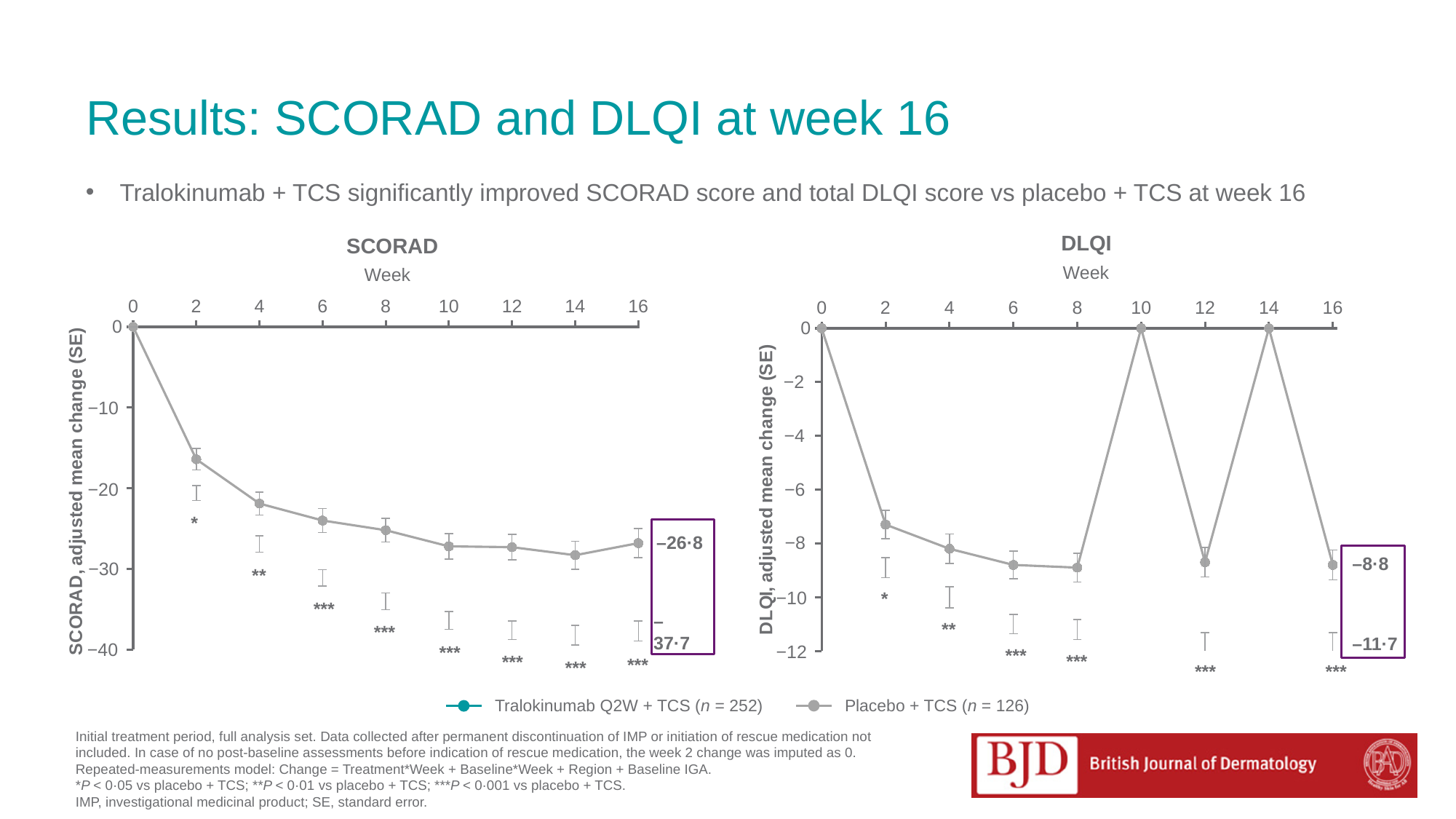
What type of chart is the SCORAD chart? line chart In the DLQI chart, is the Placebo + TCS value at week 2 greater or less than −6? less In the SCORAD chart, what is the adjusted mean change for Placebo + TCS at week 16? −26·8 In the DLQI chart, what is the difference between the two week 16 values shown, −11·7 and −8·8? 2·9 In the DLQI chart, what is the adjusted mean change for Placebo + TCS at week 16? −8·8 In the SCORAD chart, what is the difference between the two week 16 values shown, −37·7 and −26·8? 10·9 In the SCORAD chart, how many week time points are shown on the x axis? 9 In the SCORAD chart, is the Placebo + TCS value at week 2 greater or less than −10? less In the SCORAD chart, does the Placebo + TCS line rise or fall from week 0 to week 8? fall According to the legend, how many patients were in the Tralokinumab Q2W + TCS group? 252 How many series does the legend list? 2 In the SCORAD chart, which of the two week 16 values shown is lower, −37·7 or −26·8? −37·7